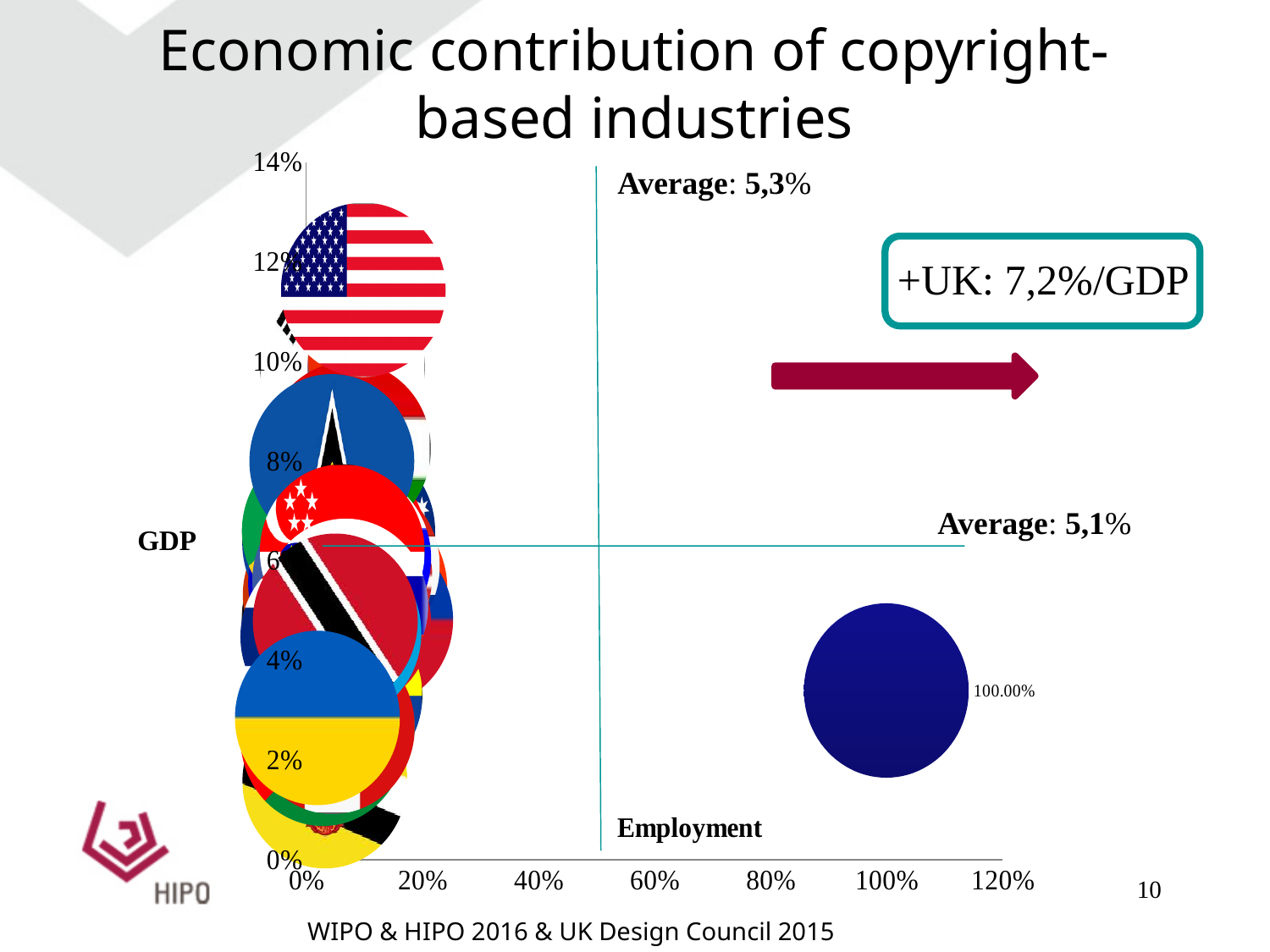
What average value is printed next to the vertical average line in the chart? 5,3% What label is shown on the vertical axis of the chart? GDP What is the title of the chart on the slide? Economic contribution of copyright-based industries Is the GDP value of the dark blue bubble labelled 100.00% greater or less than 6%? less What is the highest tick value shown on the horizontal (Employment) axis? 120% What average value is printed next to the horizontal average line in the chart? 5,1% What is the highest tick value shown on the vertical (GDP) axis? 14% What kind of chart is shown on the slide? bubble chart Is the Employment value of the dark blue bubble labelled 100.00% greater or less than 80%? greater What GDP contribution is stated for the UK in the highlighted box on the slide? 7,2%/GDP What value is printed as the data label on the dark blue bubble on the right side of the chart? 100.00%